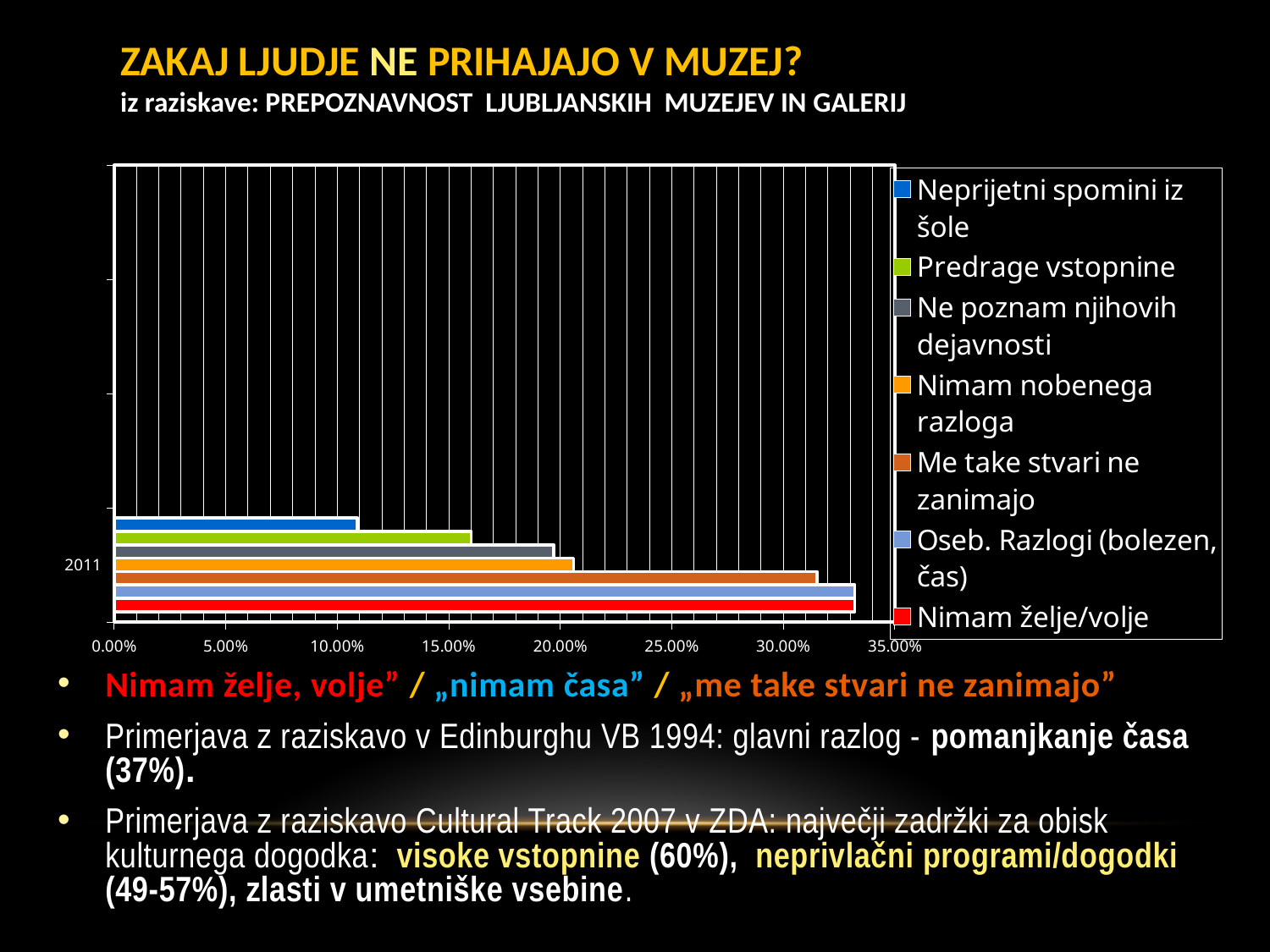
How many series does the chart legend list? 7 Is the value for Predrage vstopnine greater or less than 15.00%? greater Which is larger, the value for Me take stvari ne zanimajo or the value for Nimam nobenega razloga? Me take stvari ne zanimajo How many categories are shown on the vertical axis of the chart? 1 Is the value for Me take stvari ne zanimajo greater or less than 30.00%? greater Which category label appears on the vertical axis of the chart? 2011 Is the value for Nimam nobenega razloga greater or less than 25.00%? less Which series has the shortest bar in the chart? Neprijetni spomini iz šole Which is larger, the value for Predrage vstopnine or the value for Neprijetni spomini iz šole? Predrage vstopnine What colour is the bar for Nimam želje/volje in the chart? red What kind of chart is shown on the slide? bar chart